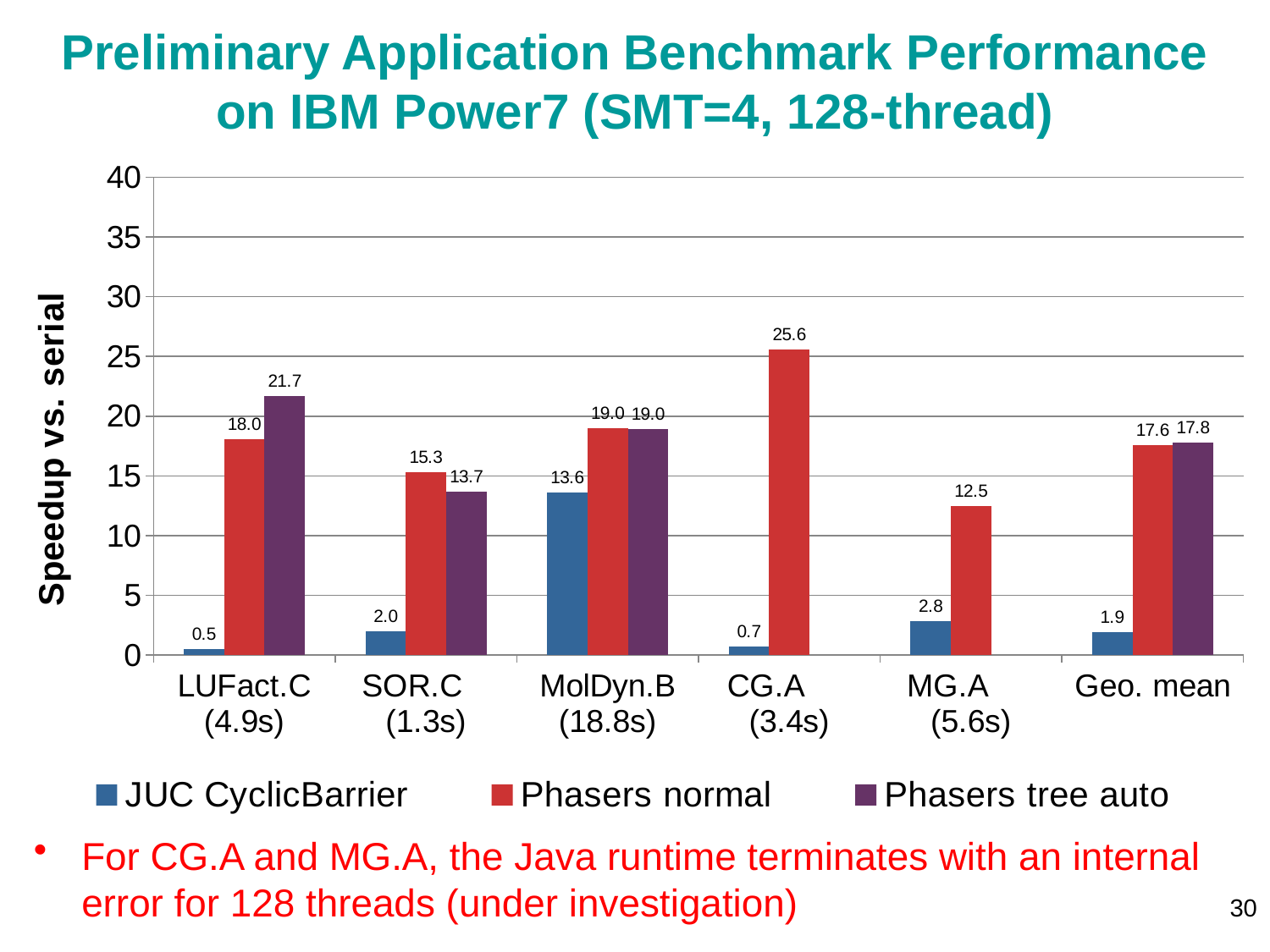
What is the Geo. mean speedup for Phasers tree auto? 17.8 How many benchmark categories are shown on the x axis? 6 Which benchmark has the lowest JUC CyclicBarrier speedup? LUFact.C (4.9s) What is the speedup for Phasers normal on CG.A (3.4s)? 25.6 What is the speedup for Phasers tree auto on LUFact.C (4.9s)? 21.7 What is the label of the y axis? Speedup vs. serial How many series does the legend list? 3 Which benchmark has the highest Phasers normal speedup? CG.A (3.4s) What kind of chart is shown on the slide? Bar chart What is the speedup for JUC CyclicBarrier on MolDyn.B (18.8s)? 13.6 On SOR.C (1.3s), which is larger: the Phasers normal speedup or the Phasers tree auto speedup? Phasers normal What is the difference between the Phasers tree auto and Phasers normal speedups on LUFact.C (4.9s)? 3.7